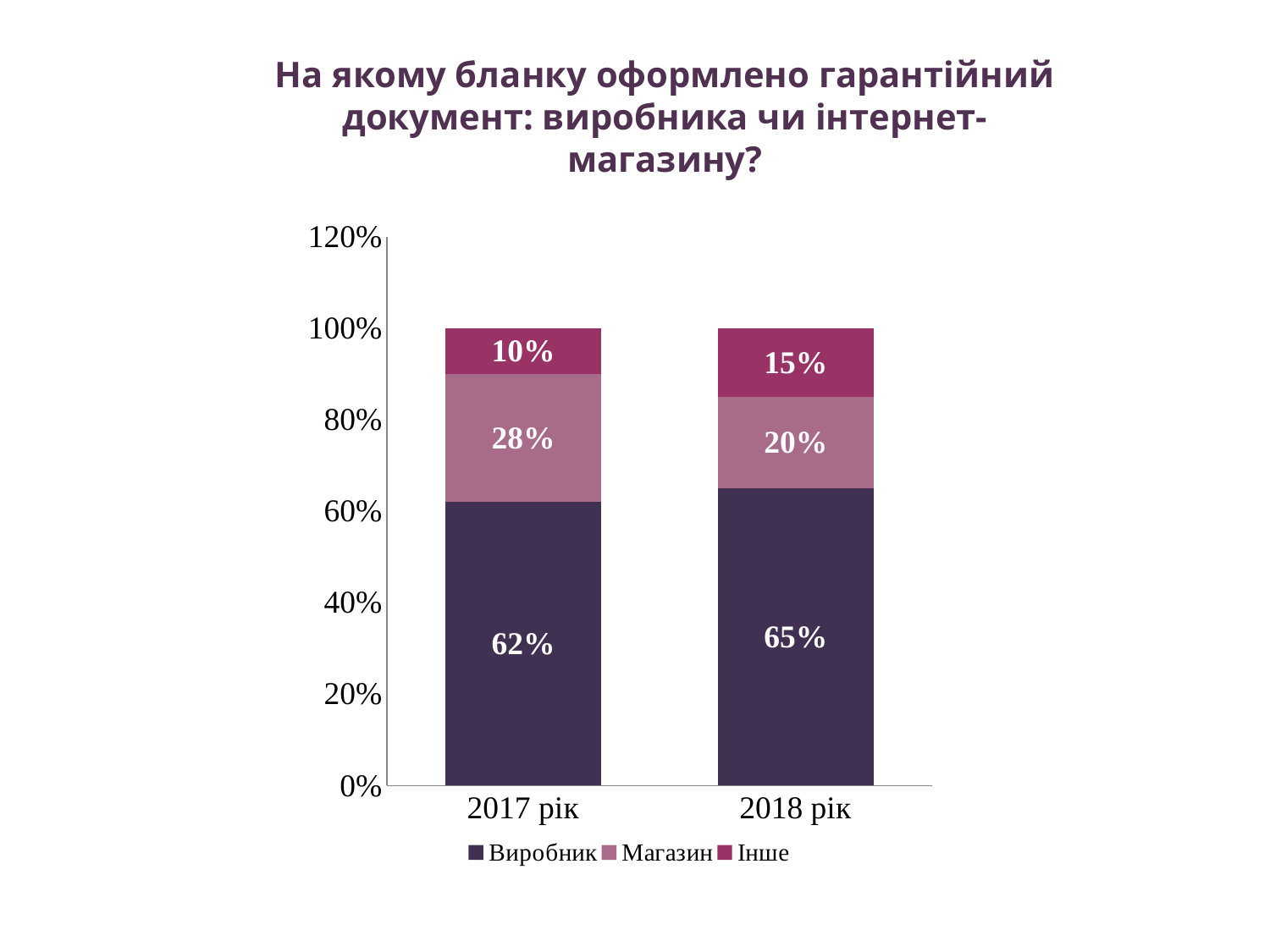
What is the value for Магазин in 2018 рік? 20% What is the total of the stacked bar for 2017 рік? 100% How many series does the legend list? 3 Does the value for Виробник rise or fall from 2017 рік to 2018 рік? Rise What is the difference between the Магазин values for 2017 рік and 2018 рік? 8% What is the value for Виробник in 2017 рік? 62% Which year has the higher value for Магазин? 2017 рік What is the value for Інше in 2017 рік? 10% How many categories are shown on the x axis? 2 What is the value for Виробник in 2018 рік? 65% What is the difference between the Інше values for 2018 рік and 2017 рік? 5% What kind of chart is shown on the slide? Stacked bar chart